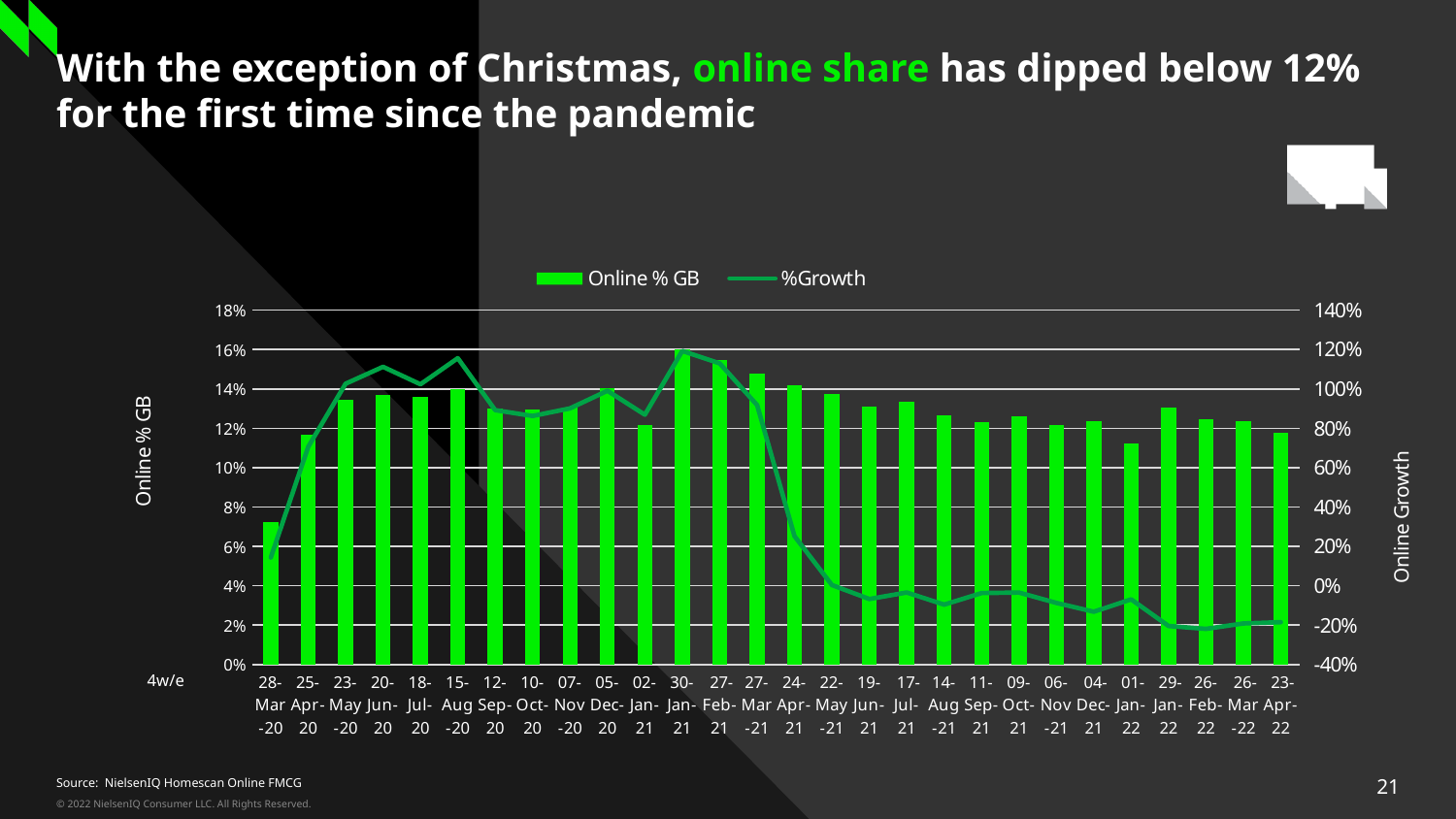
Which period has the lowest Online % GB bar? 28-Mar-20 What kind of chart is shown on the slide? A combined bar and line chart How many 4w/e periods are plotted along the x axis? 28 What are the two series named in the legend? Online % GB and %Growth How many series does the legend list? 2 Which has the larger Online % GB bar, 28-Mar-20 or 25-Apr-20? 25-Apr-20 Which period has the highest Online % GB bar? 30-Jan-21 Is the Online % GB value for 28-Mar-20 greater or less than 8%? less Is the Online % GB value for 01-Jan-22 greater or less than 12%? less Is the %Growth value for 23-Apr-22 greater or less than 0%? less What is the title of the right-hand vertical axis? Online Growth